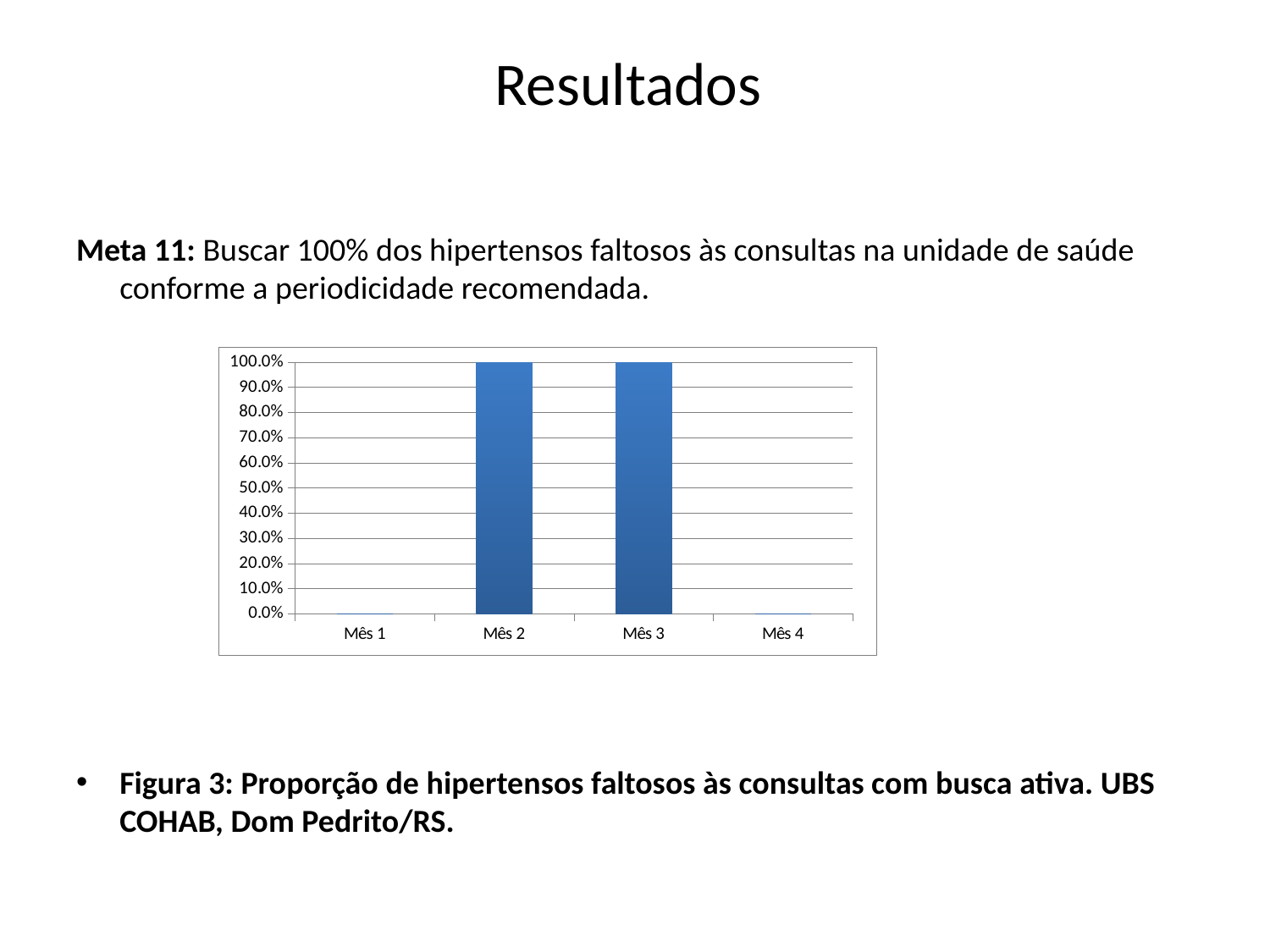
What is the value for Mês 3? 100.0% What kind of chart is shown on the slide? bar chart What is the difference between the value for Mês 3 and the value for Mês 4? 100.0% How many categories are shown on the x axis of the chart? 4 Is the value for Mês 2 greater or less than 50.0%? greater Does the value rise or fall from Mês 1 to Mês 2? rise What is the value for Mês 1? 0.0% Which is larger, the value for Mês 2 or the value for Mês 1? Mês 2 What is the value for Mês 2? 100.0% What is the value for Mês 4? 0.0% Which months have a visible bar in the chart? Mês 2 and Mês 3 Which is larger, the value for Mês 3 or the value for Mês 4? Mês 3